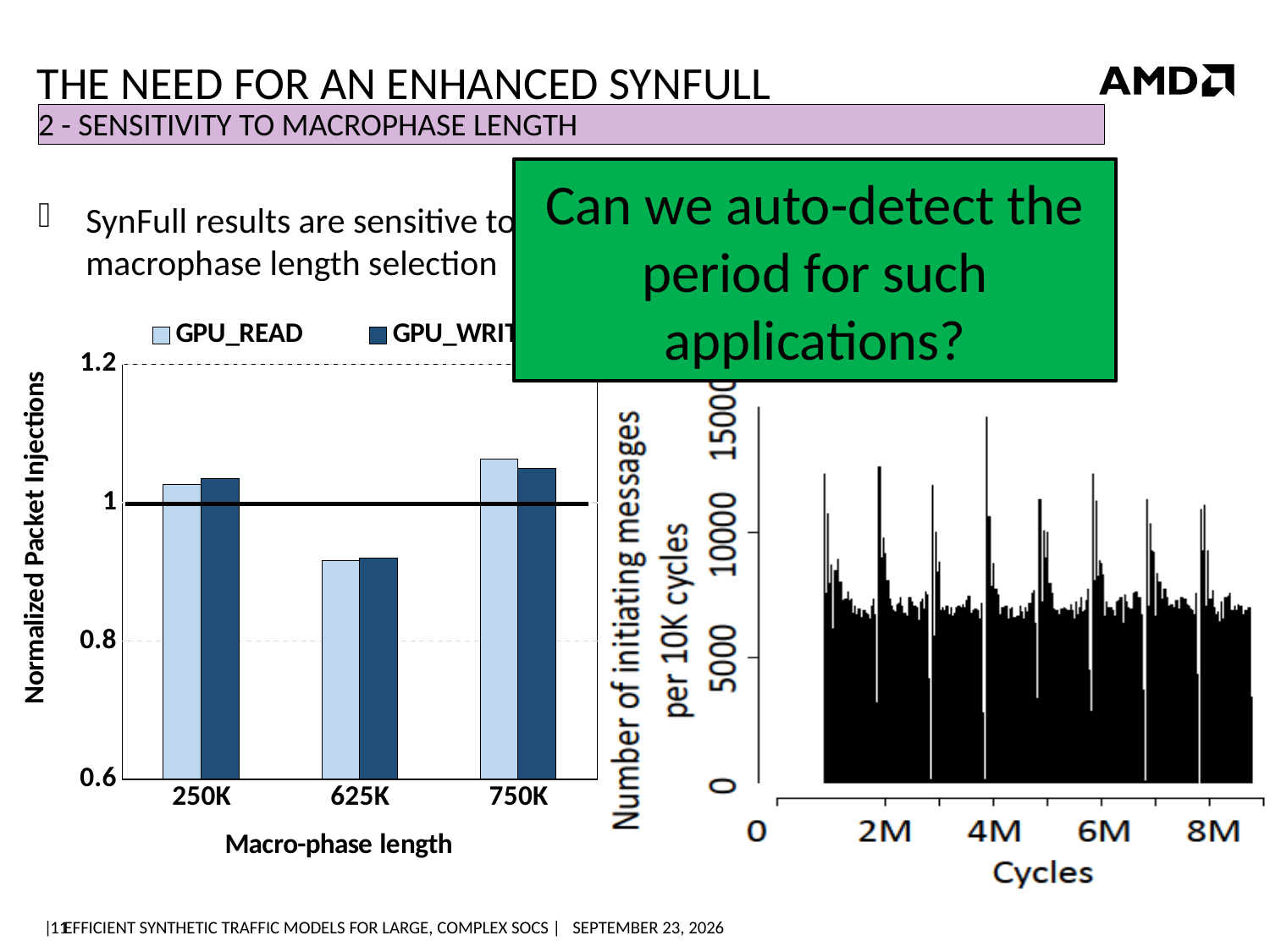
On the right chart, what is the label of the x axis? Cycles On the left chart, how many macro-phase length categories are shown on the x axis? 3 On the right chart, what is the highest tick value shown on the y axis? 15000 On the left chart, which is larger: the GPU_READ value for 750K or the GPU_READ value for 625K? 750K On the left chart, what kind of chart is it? bar chart On the left chart, which macro-phase length has the lowest GPU_READ normalized packet injections? 625K On the left chart, is the GPU_WRITE value for 750K greater or less than 1? greater On the left chart, how many series does the legend list? 2 On the left chart, is the GPU_READ value for 250K greater or less than 0.8? greater On the left chart, which macro-phase length has the highest GPU_READ normalized packet injections? 750K On the left chart, what is the label of the x axis? Macro-phase length On the left chart, is the GPU_READ value for 625K greater or less than 1? less